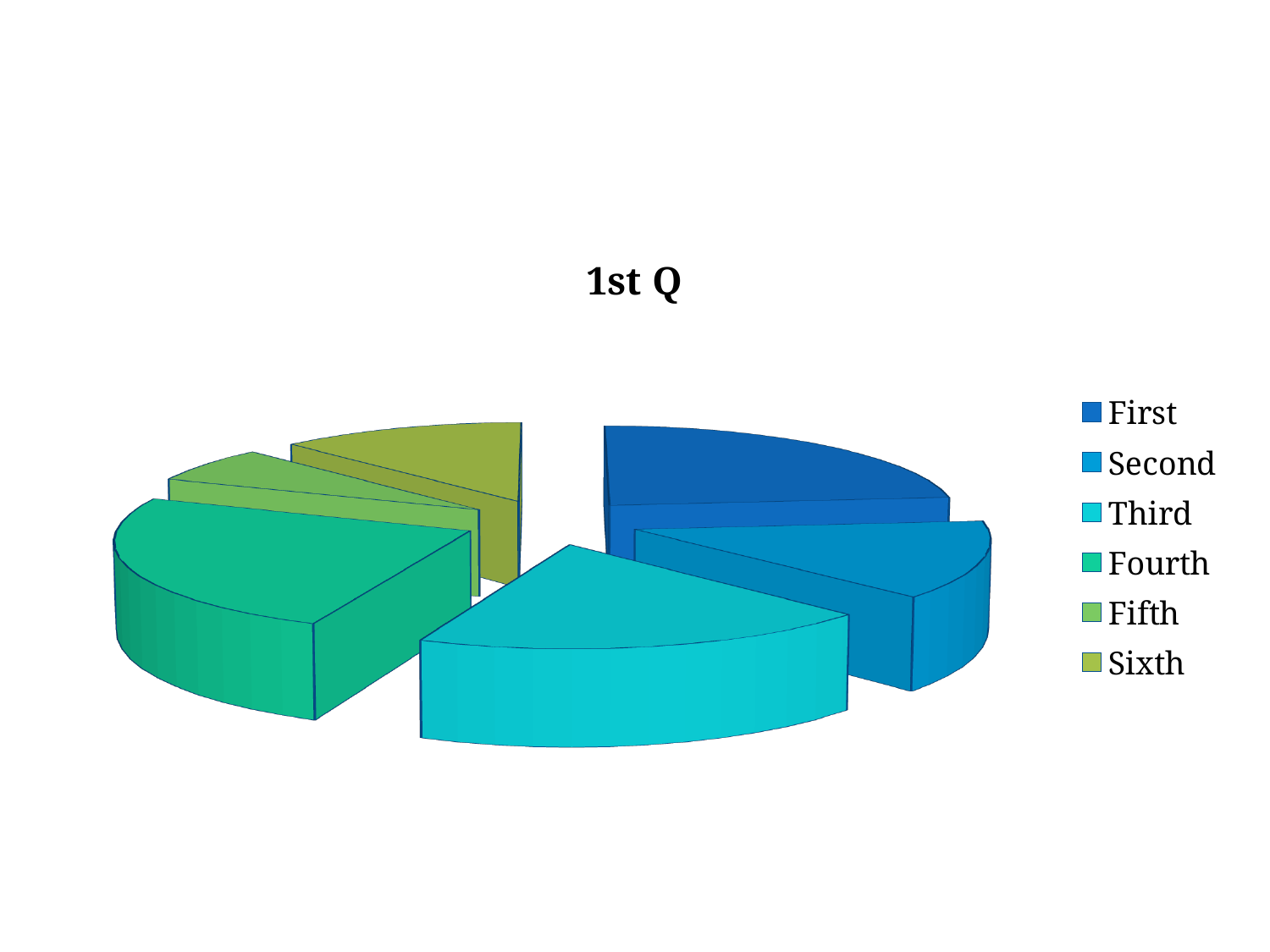
How many entries does the legend list? 6 Which slice is larger, Fourth or Fifth? Fourth How many slices does the pie chart have? 6 What is the title of the chart? 1st Q Which slice is larger, Third or Fifth? Third What kind of chart is shown on the slide? Pie chart Which slice is larger, First or Fifth? First Which category has the smallest slice of the pie? Fifth On which side of the chart is the legend placed? Right